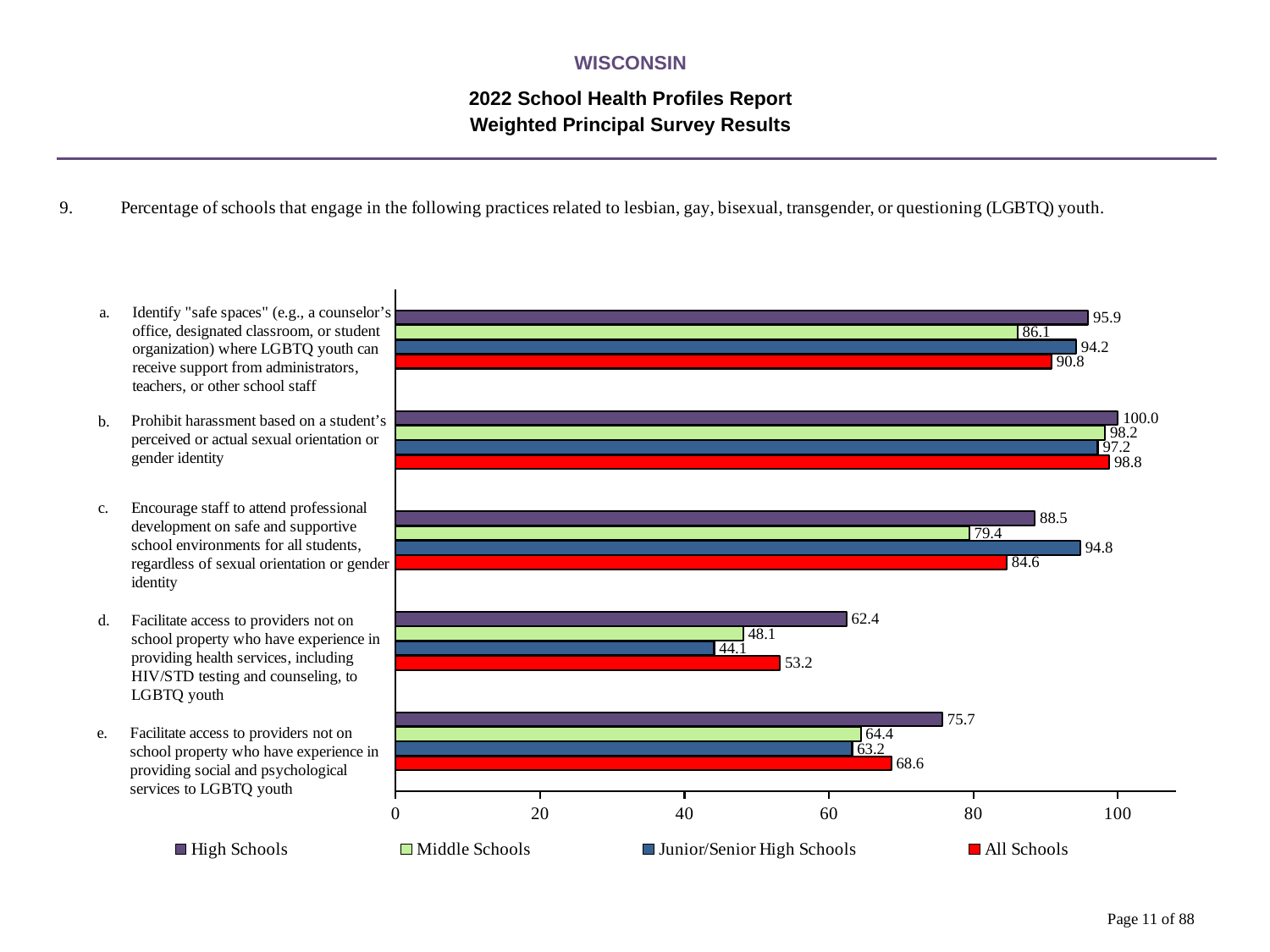
What is the Junior/Senior High Schools value for practice a (Identify "safe spaces" where LGBTQ youth can receive support)? 94.2 Which school type has the highest value for practice c (Encourage staff to attend professional development on safe and supportive school environments)? Junior/Senior High Schools What is the value for High Schools for practice b (Prohibit harassment based on a student's perceived or actual sexual orientation or gender identity)? 100.0 Which colour represents All Schools in the chart? Red What is the value for Middle Schools for practice d (Facilitate access to providers not on school property who have experience in providing health services, including HIV/STD testing and counseling, to LGBTQ youth)? 48.1 For practice d (Facilitate access to providers for health services), which is larger: the Middle Schools value or the Junior/Senior High Schools value? Middle Schools What kind of chart is shown on the slide? Bar chart What is the All Schools value for practice e (Facilitate access to providers not on school property who have experience in providing social and psychological services to LGBTQ youth)? 68.6 How many practices (categories) are shown on the chart? 5 How many series does the legend list? 4 What is the difference between the High Schools and Middle Schools values for practice c (Encourage staff to attend professional development)? 9.1 Which practice has the lowest All Schools value? d. Facilitate access to providers not on school property who have experience in providing health services, including HIV/STD testing and counseling, to LGBTQ youth